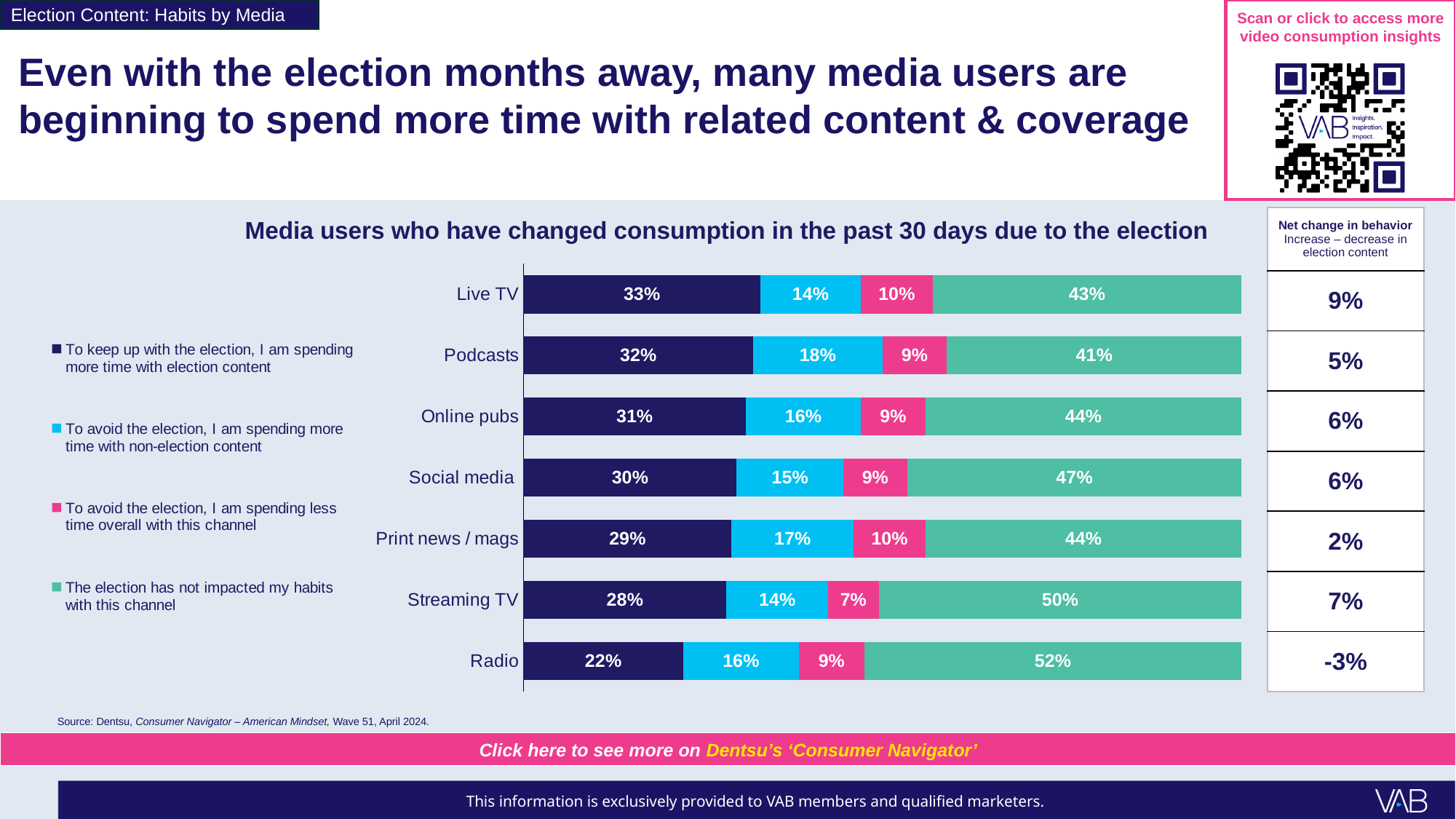
Which media channel has the lowest share of users saying they are spending less time overall with the channel to avoid the election? Streaming TV How many series does the chart legend list? 4 What is the title of the chart? Media users who have changed consumption in the past 30 days due to the election Going down the chart from Live TV to Radio, do the 'spending more time with election content' values rise or fall? Fall What percentage of Radio users say they are spending more time with election content to keep up with the election? 22% Which has a larger share of users spending more time with non-election content to avoid the election: Podcasts or Social media? Podcasts What type of chart is used to show media users who have changed consumption due to the election? Stacked bar chart How many percentage points higher is the 'spending more time with election content' share for Live TV than for Radio? 11 percentage points What percentage of Streaming TV users say the election has not impacted their habits with this channel? 50% Which media channel has the highest share of users saying the election has not impacted their habits? Radio How many media channels are shown in the chart? 7 What percentage of Live TV users say the election has not impacted their habits with this channel? 43%